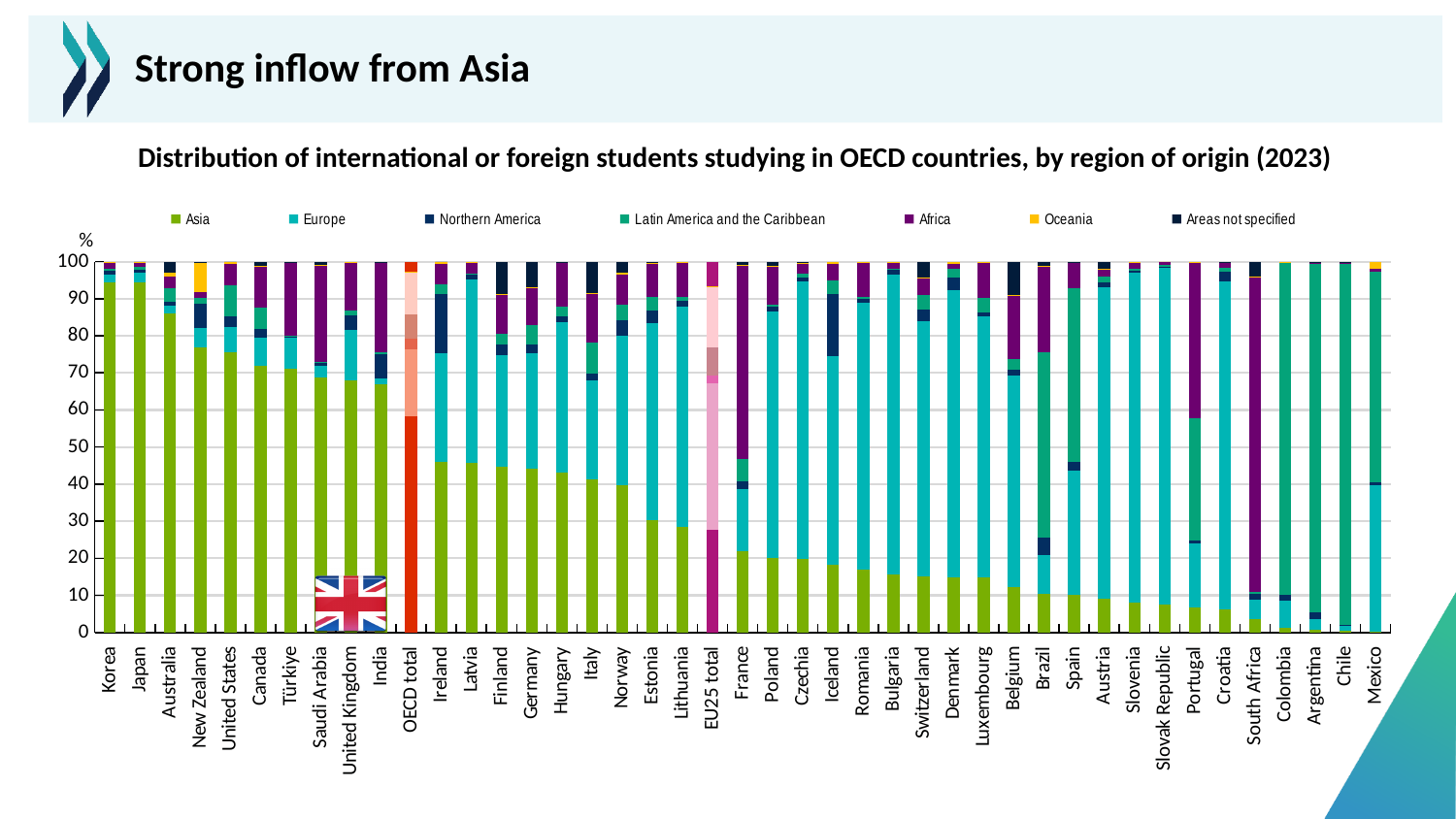
Is the Asia share for Korea greater or less than 90? greater Is the Asia share for Saudi Arabia greater or less than 60? greater How many series does the legend list? 7 Which has a larger Asia share, Australia or Ireland? Australia Which has a larger Europe share, Mexico or Korea? Mexico How many countries or totals are shown along the x axis? 43 Is the Asia share for Mexico greater or less than 10? less What is the title of the chart? Distribution of international or foreign students studying in OECD countries, by region of origin (2023) What kind of chart is shown on the slide? stacked bar chart Does the Asia share generally rise or fall moving from left to right along the x axis? fall